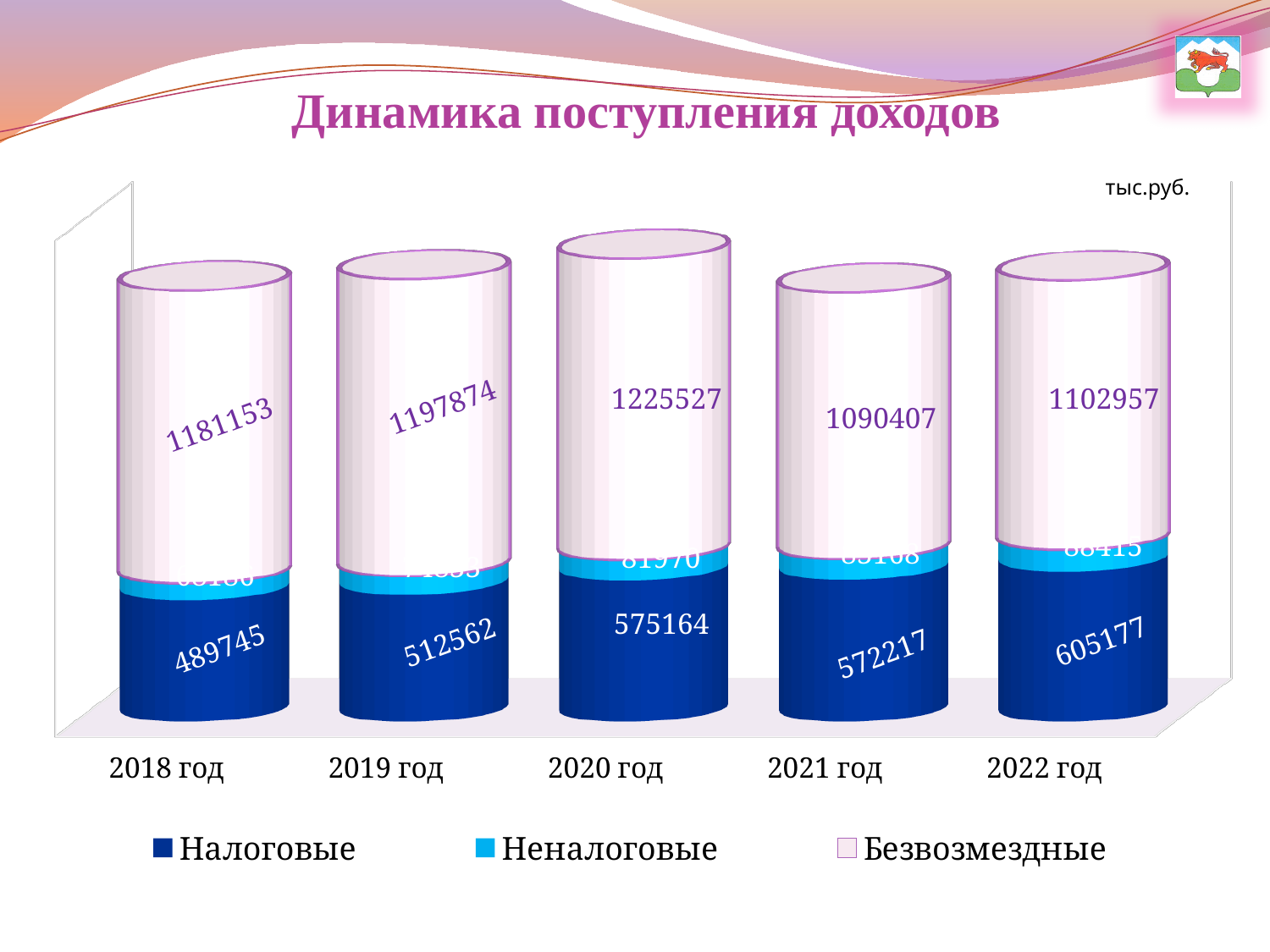
In which year is the Налоговые value the lowest? 2018 год What unit is indicated in the top right corner of the chart? тыс.руб. In which year is the Налоговые value the highest? 2022 год In which year is the Безвозмездные value the highest? 2020 год How many series does the legend list? 3 What is the value of Налоговые for 2020 год? 575164 Which year has the larger Безвозмездные value, 2019 год or 2022 год? 2019 год What is the difference between the Налоговые values for 2022 год and 2018 год? 115432 What kind of chart is shown on the slide? bar chart In which year is the Безвозмездные value the lowest? 2021 год How many years are shown on the x axis of the chart? 5 What is the value of Безвозмездные for 2021 год? 1090407